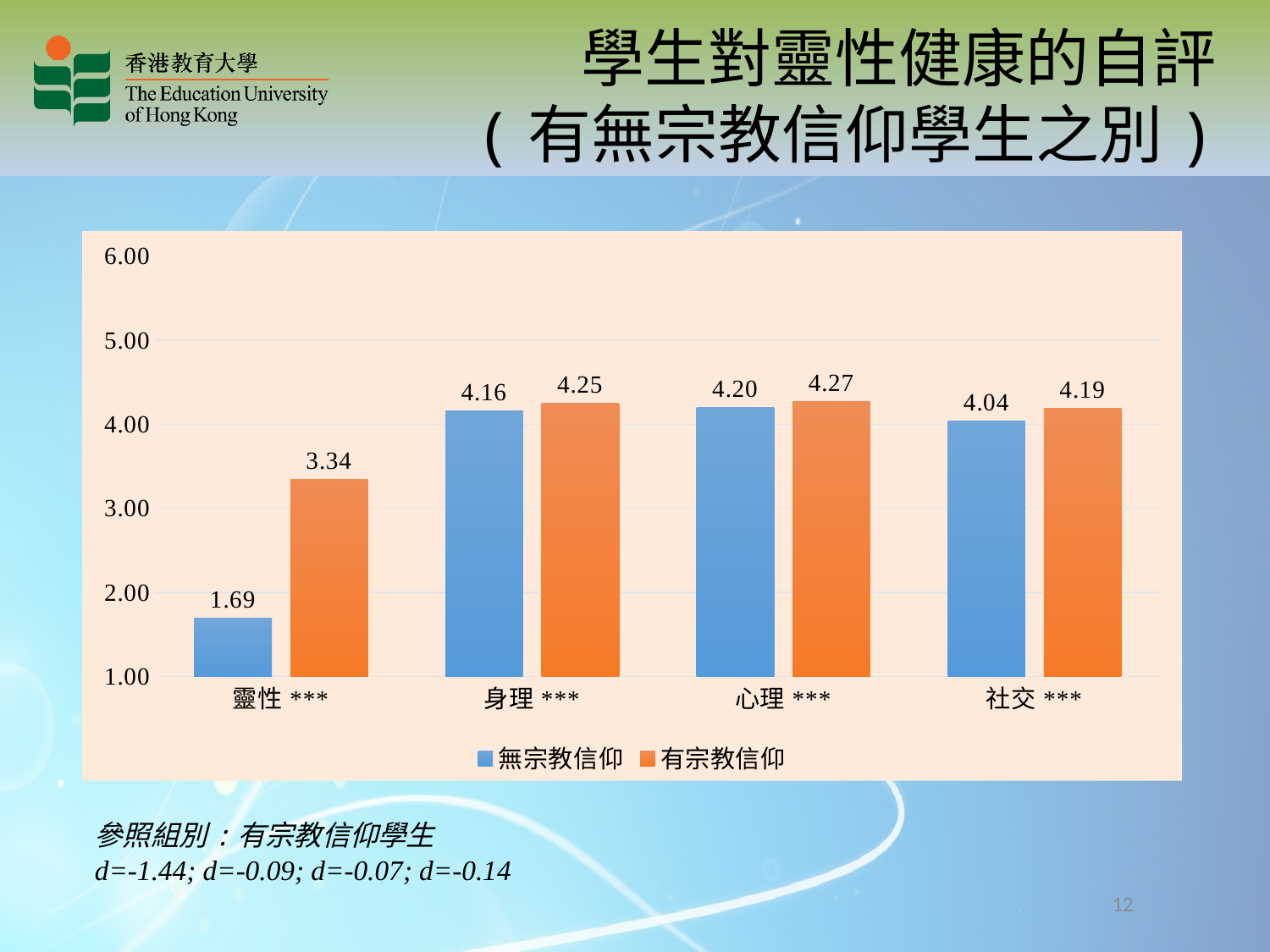
Which is larger in the 身理 *** category: 無宗教信仰 or 有宗教信仰? 有宗教信仰 How many series does the legend list? 2 What is the value for 無宗教信仰 in the 靈性 *** category? 1.69 What is the difference between 有宗教信仰 and 無宗教信仰 in the 靈性 *** category? 1.65 How many categories are shown on the x axis? 4 What is the value for 有宗教信仰 in the 心理 *** category? 4.27 What is the value for 無宗教信仰 in the 社交 *** category? 4.04 Which category has the highest value for 有宗教信仰? 心理 *** What kind of chart is shown on the slide? bar chart Which category has the lowest value for 無宗教信仰? 靈性 *** Is the value for 無宗教信仰 in the 靈性 *** category greater or less than 2.00? less What is the difference between 有宗教信仰 and 無宗教信仰 in the 社交 *** category? 0.15